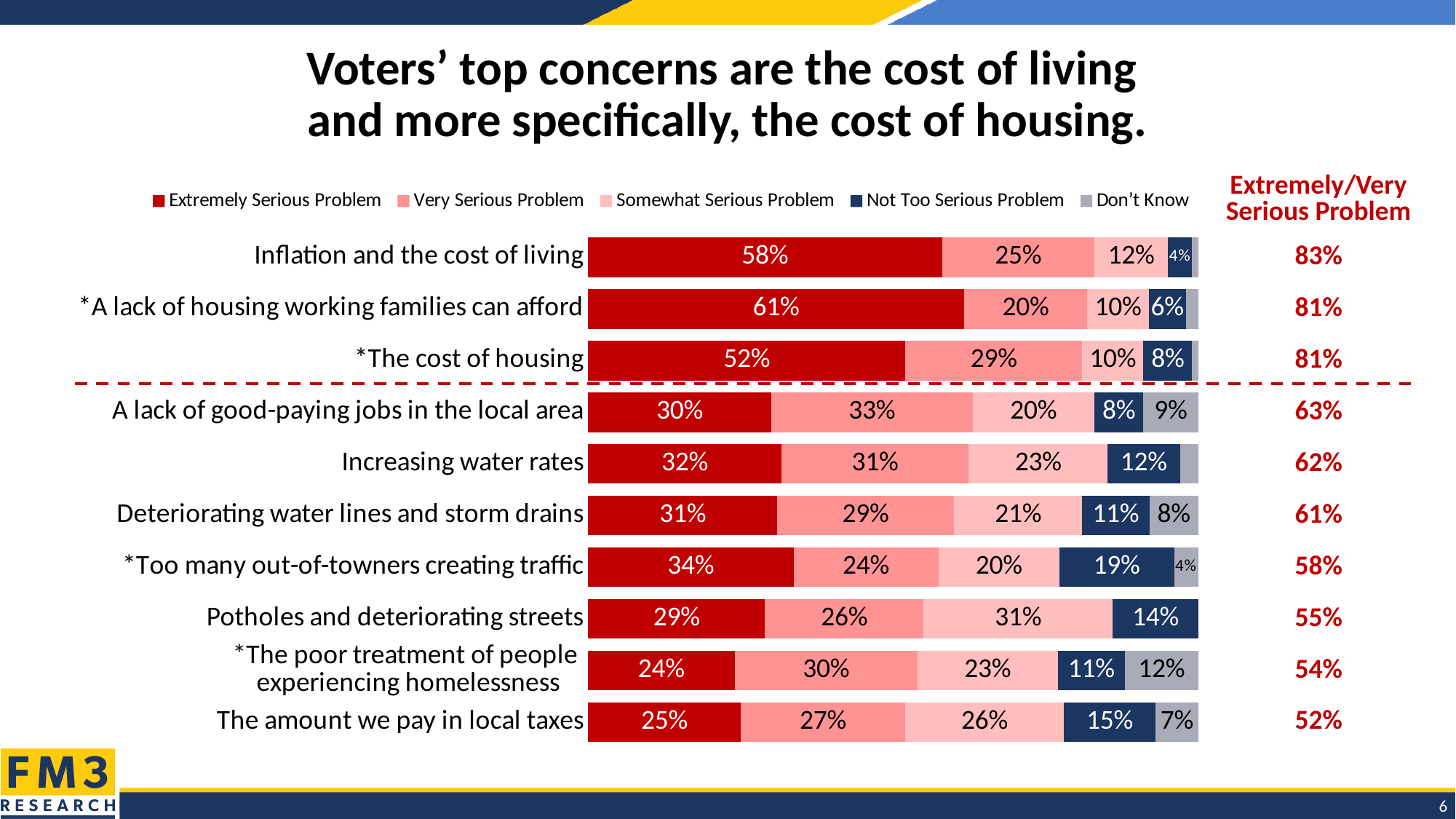
What is the Very Serious Problem value for 'The cost of housing'? 29% How many categories (issues) are shown in the chart? 10 Which category has the highest Extremely Serious Problem percentage? A lack of housing working families can afford What percentage of voters rated 'Inflation and the cost of living' an Extremely Serious Problem? 58% Which category has the lowest Extremely Serious Problem percentage? The poor treatment of people experiencing homelessness What kind of chart is shown on the slide? Stacked bar chart What is the Don't Know value for 'The poor treatment of people experiencing homelessness'? 12% Which has a larger Very Serious Problem value: 'A lack of good-paying jobs in the local area' or 'Increasing water rates'? A lack of good-paying jobs in the local area What is the Not Too Serious Problem value for 'Too many out-of-towners creating traffic'? 19% What is the difference between the Extremely Serious Problem values for 'Inflation and the cost of living' and 'The cost of housing'? 6 percentage points What is the combined Extremely/Very Serious Problem value for 'Potholes and deteriorating streets'? 55% How many series does the legend list? 5